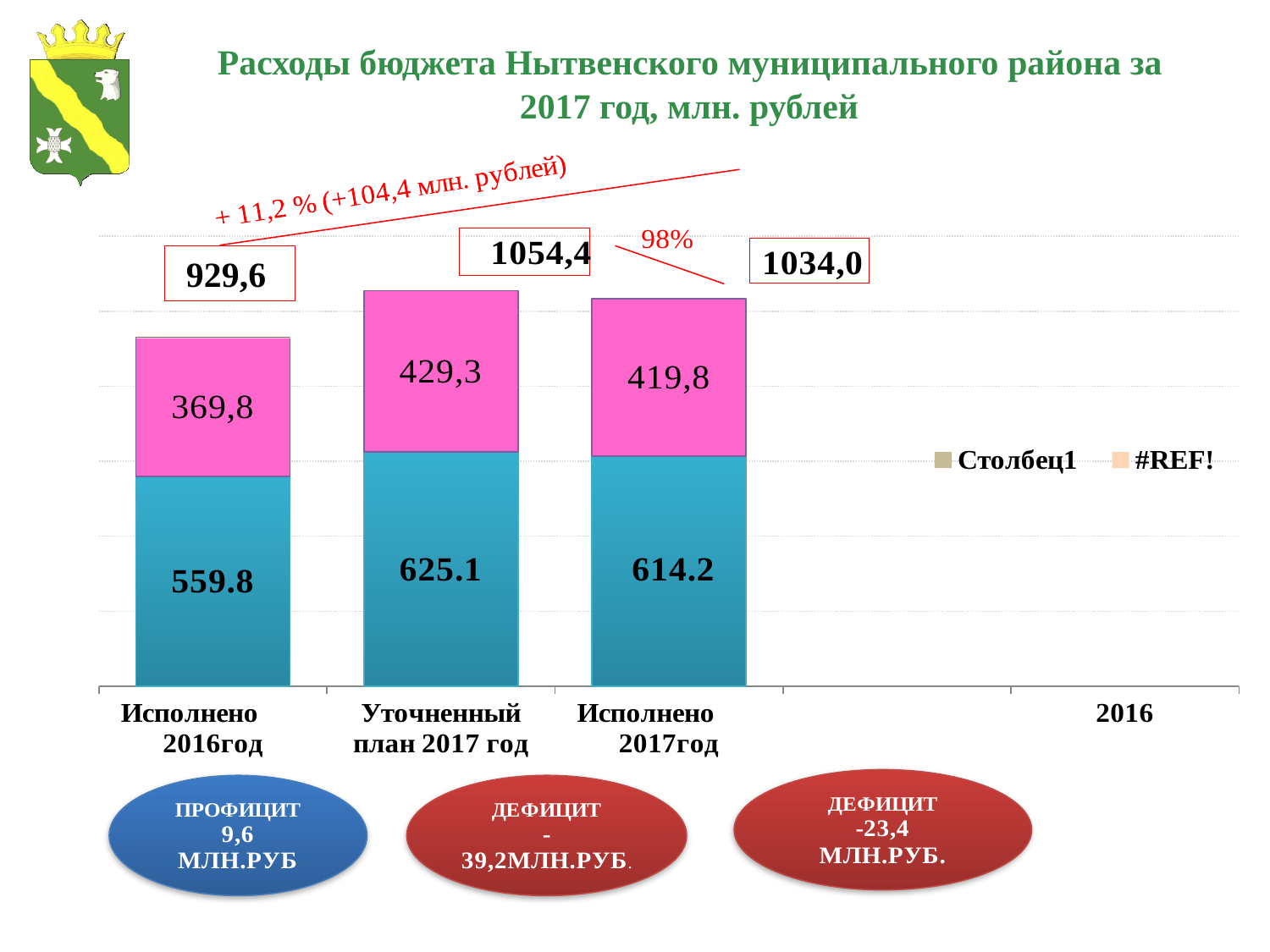
What kind of chart is shown on the slide? bar chart How many stacked bars are plotted in the chart? 3 What percentage change is written in red above the first two bars? + 11,2 % What is the total shown above the bar for Исполнено 2017год? 1034,0 Which bar has the lowest total? Исполнено 2016год What is the value of the pink (top) segment for Исполнено 2017год? 419,8 How many entries does the legend list? 2 What is the value of the pink (top) segment for Уточненный план 2017 год? 429,3 What is the difference between the totals for Уточненный план 2017 год (1054,4) and Исполнено 2017год (1034,0)? 20,4 Which bar has the highest total? Уточненный план 2017 год What is the value of the blue (bottom) segment for Исполнено 2016год? 559.8 Which has the larger blue (bottom) segment: Уточненный план 2017 год or Исполнено 2017год? Уточненный план 2017 год